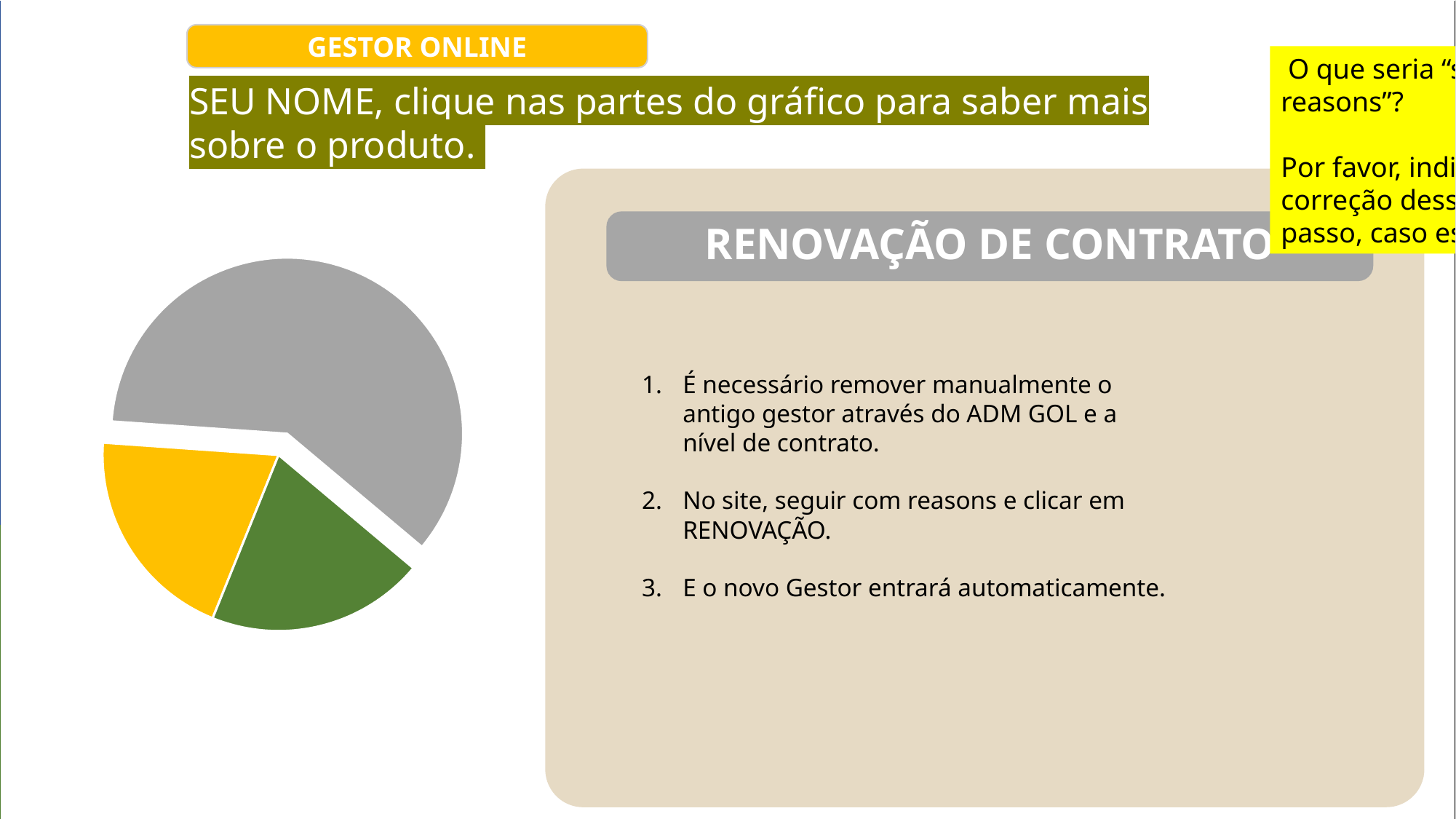
How many slices does the pie chart have? 3 Is the gray slice of the pie chart larger or smaller than the yellow slice? larger Is the gray slice of the pie chart larger or smaller than the green slice? larger Which slice of the pie chart is the largest? the gray slice Does the gray slice take up more or less than half of the pie chart? more What kind of chart is shown on the left of the slide? pie chart Does the pie chart display a legend or data labels? No What colours are the three slices of the pie chart? gray, yellow and green